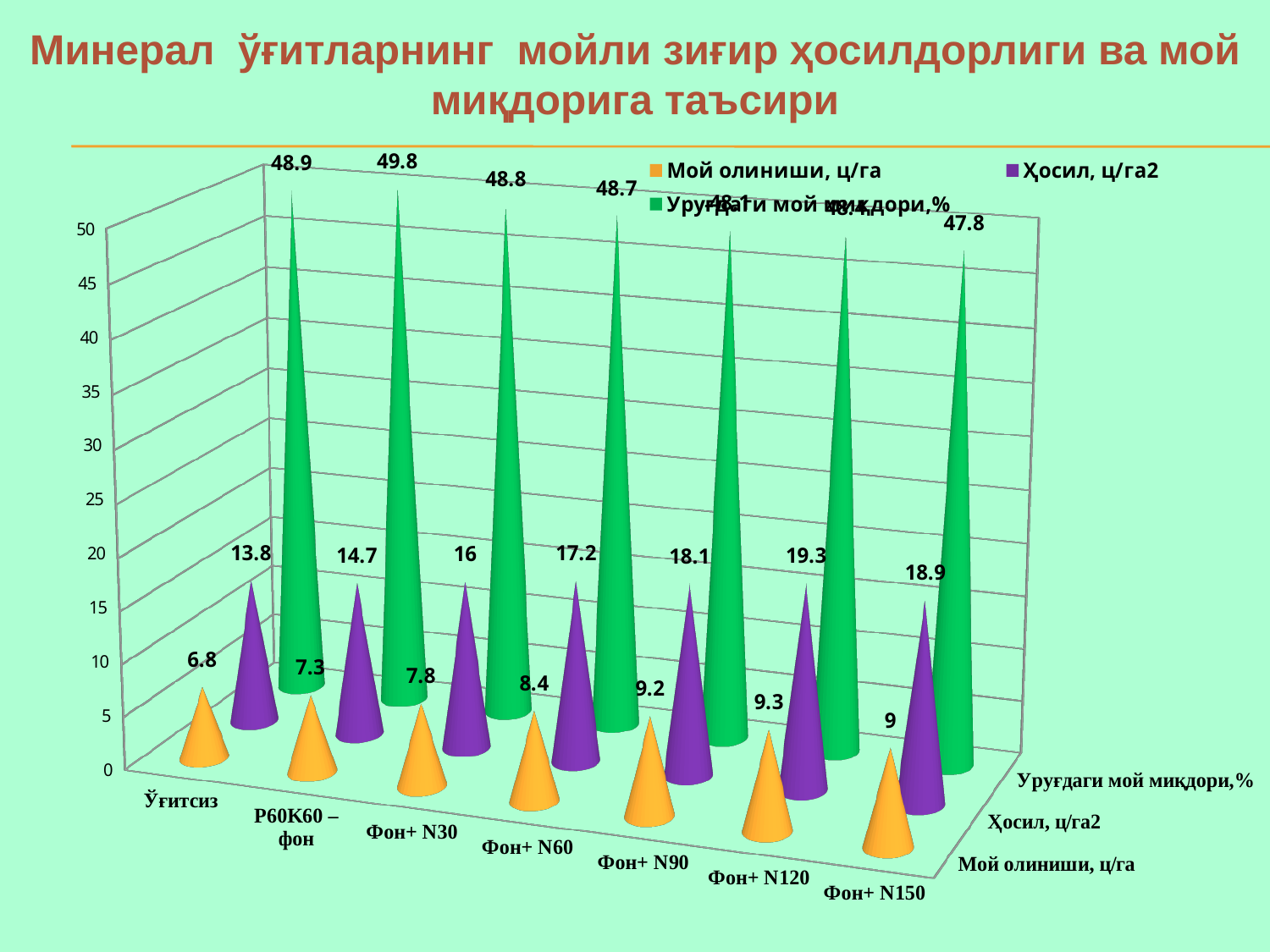
Which is larger: the Уруғдаги мой миқдори,% value for P60K60 – фон or for Фон+ N150? P60K60 – фон Which colour represents the series Ҳосил, ц/га2? Purple What is the value of Уруғдаги мой миқдори,% for P60K60 – фон? 49.8 Which category has the highest value for Ҳосил, ц/га2? Фон+ N120 What kind of chart is shown on the slide? 3D bar chart How many categories are shown on the x axis? 7 How many series does the legend list? 3 What is the value of Мой олиниши, ц/га for Ўғитсиз? 6.8 What is the value of Ҳосил, ц/га2 for Фон+ N120? 19.3 Which category has the lowest value for Мой олиниши, ц/га? Ўғитсиз What is the difference between the Ҳосил, ц/га2 values for Фон+ N120 and Ўғитсиз? 5.5 What is the value of Мой олиниши, ц/га for Фон+ N150? 9